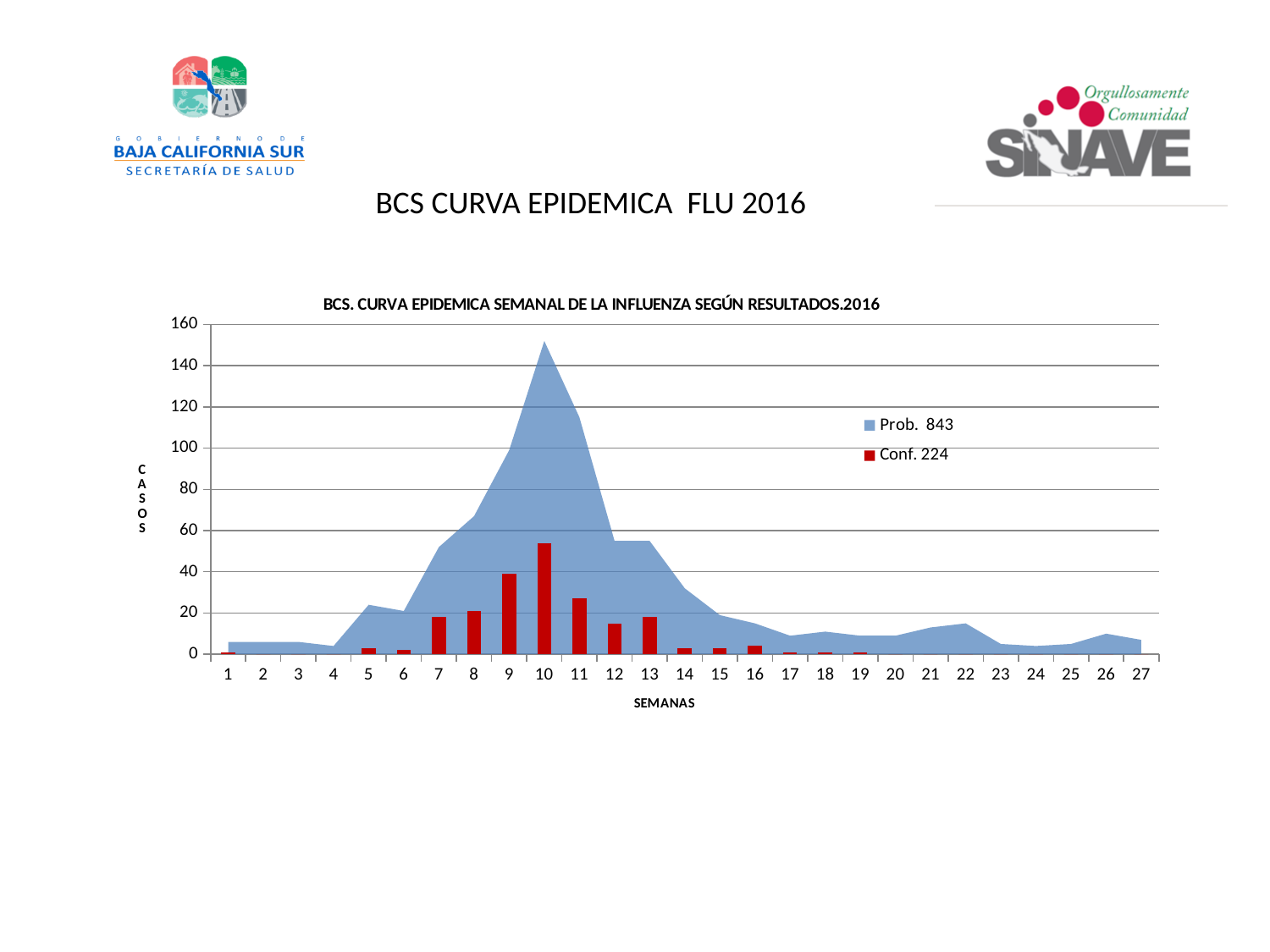
Which is larger, the Conf. value for week 9 or for week 11? week 9 How many series does the chart legend list? 2 What are the two entries in the chart legend? Prob. 843 and Conf. 224 What is the title printed above the chart? BCS. CURVA EPIDEMICA SEMANAL DE LA INFLUENZA SEGÚN RESULTADOS.2016 Is the Prob. value for week 7 greater or less than 40? greater Do the Prob. values rise or fall from week 10 to week 17? fall Is the Prob. value for week 22 greater or less than 20? less Is the Conf. value for week 10 greater or less than 40? greater In which week does the Conf. series reach its highest value? 10 In which week does the Prob. series reach its highest value? 10 How many weeks are shown on the x axis of the chart? 27